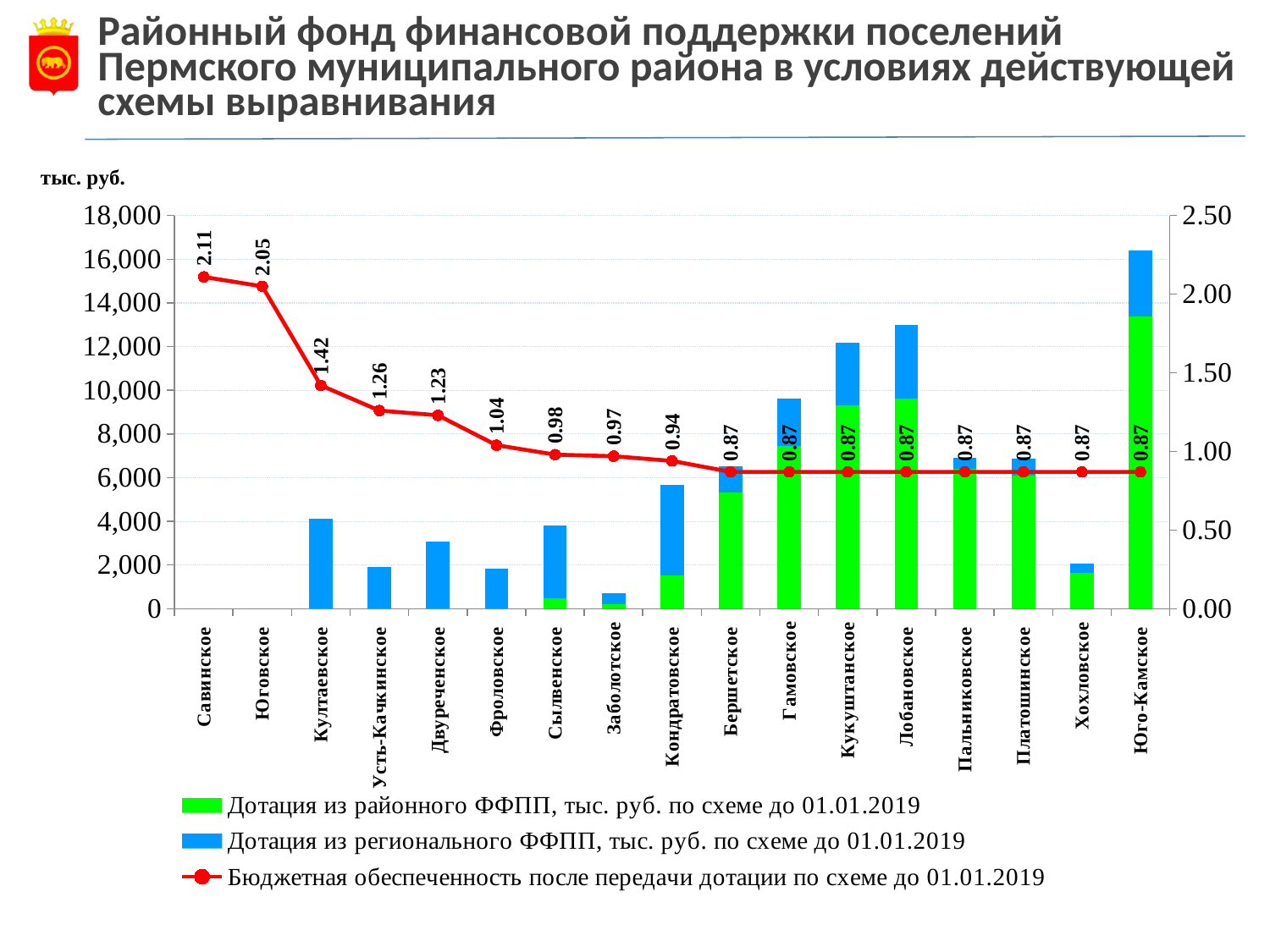
Which settlement has the highest budget provision value on the red line? Савинское What is the budget provision value shown for Фроловское? 1.04 Is the total stacked bar value for Юго-Камское greater or less than 14,000? greater What is the difference between the budget provision values of Савинское and Култаевское? 0.69 What is the budget provision value shown for Кондратовское? 0.94 How many settlements are shown on the x axis? 17 Is the total stacked bar value for Заболотское greater or less than 2,000? less Which settlement has the tallest stacked bar (largest total subsidy)? Юго-Камское What is the budget provision (Бюджетная обеспеченность) value shown for Савинское? 2.11 Which has a higher budget provision value, Усть-Качкинское or Сылвенское? Усть-Качкинское What is the budget provision value shown for Култаевское? 1.42 How many series does the legend list? 3